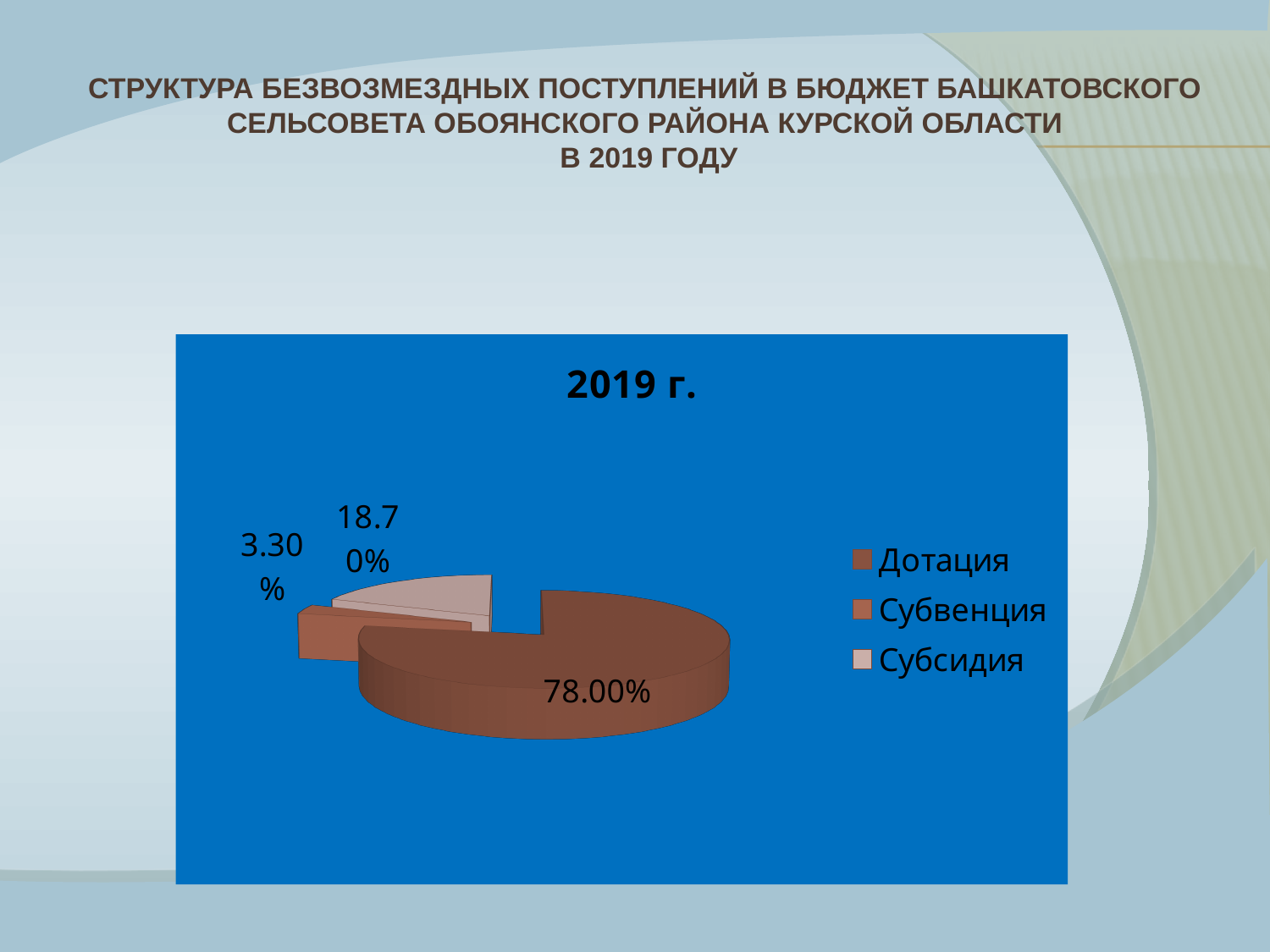
Which is larger, the share for Субсидия or the share for Субвенция? Субсидия Which category has the smallest share of the pie? Субвенция What kind of chart is shown on the slide? pie chart How many entries does the legend list? 3 What is the difference between the shares of Дотация and Субсидия? 59.30% Which legend entry is shown in the lightest colour? Субсидия What is the chart's title? 2019 г. What share of the pie does Дотация have? 78.00% Which category has the largest share of the pie? Дотация What share of the pie does Субсидия have? 18.70% What share of the pie does Субвенция have? 3.30% How many slices does the pie chart have? 3